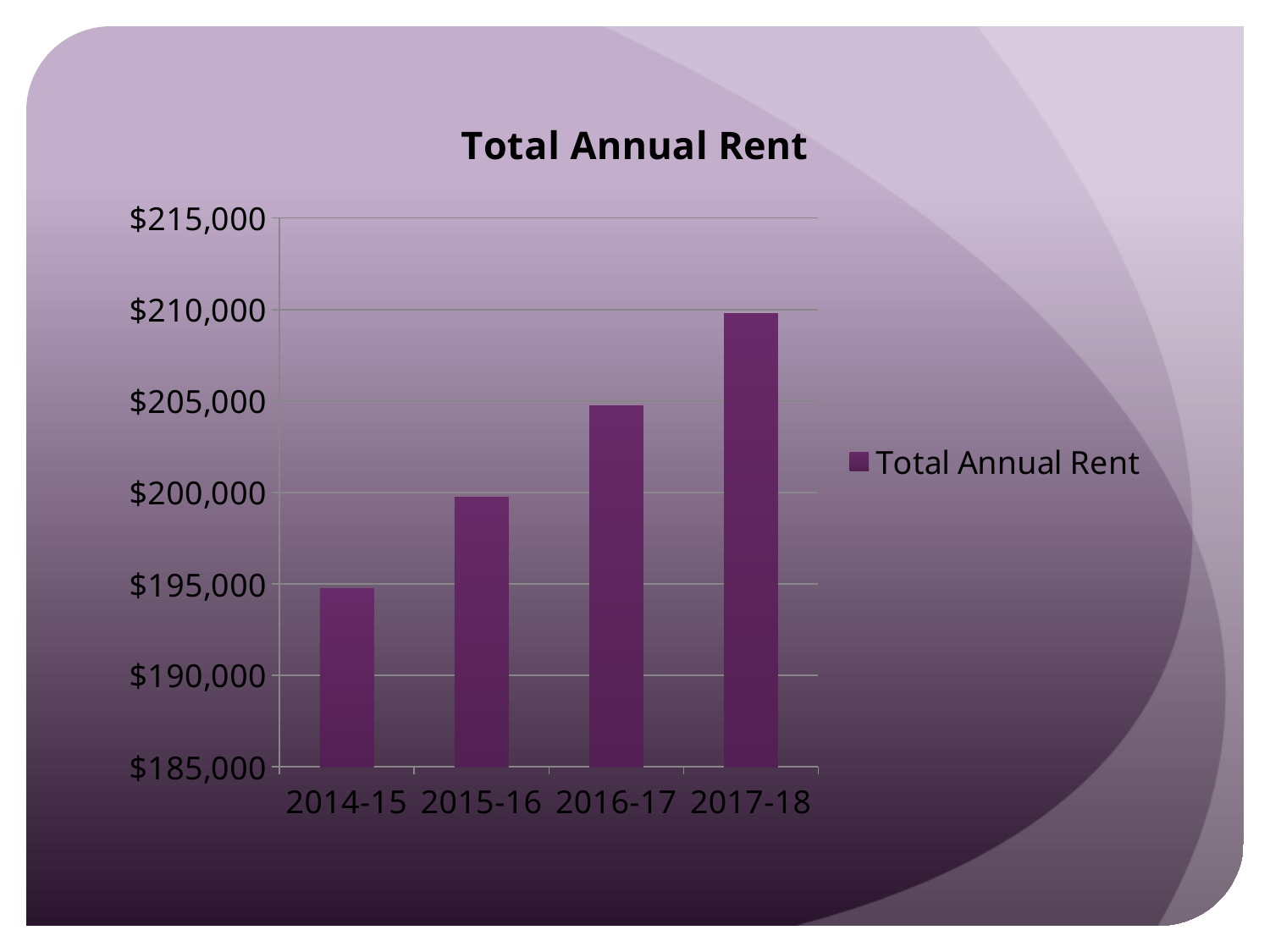
What type of chart is shown on the slide? bar chart How many series does the legend list? 1 Is the Total Annual Rent for 2014-15 greater or less than $190,000? greater Which year has the highest Total Annual Rent? 2017-18 Is the Total Annual Rent for 2016-17 greater or less than $200,000? greater Is the Total Annual Rent for 2017-18 greater or less than $205,000? greater Which year has the lowest Total Annual Rent? 2014-15 Do the Total Annual Rent values rise or fall from 2014-15 to 2017-18? rise What is the title of the chart? Total Annual Rent Which is larger, the Total Annual Rent for 2015-16 or for 2017-18? 2017-18 How many categories are shown on the x axis of the chart? 4